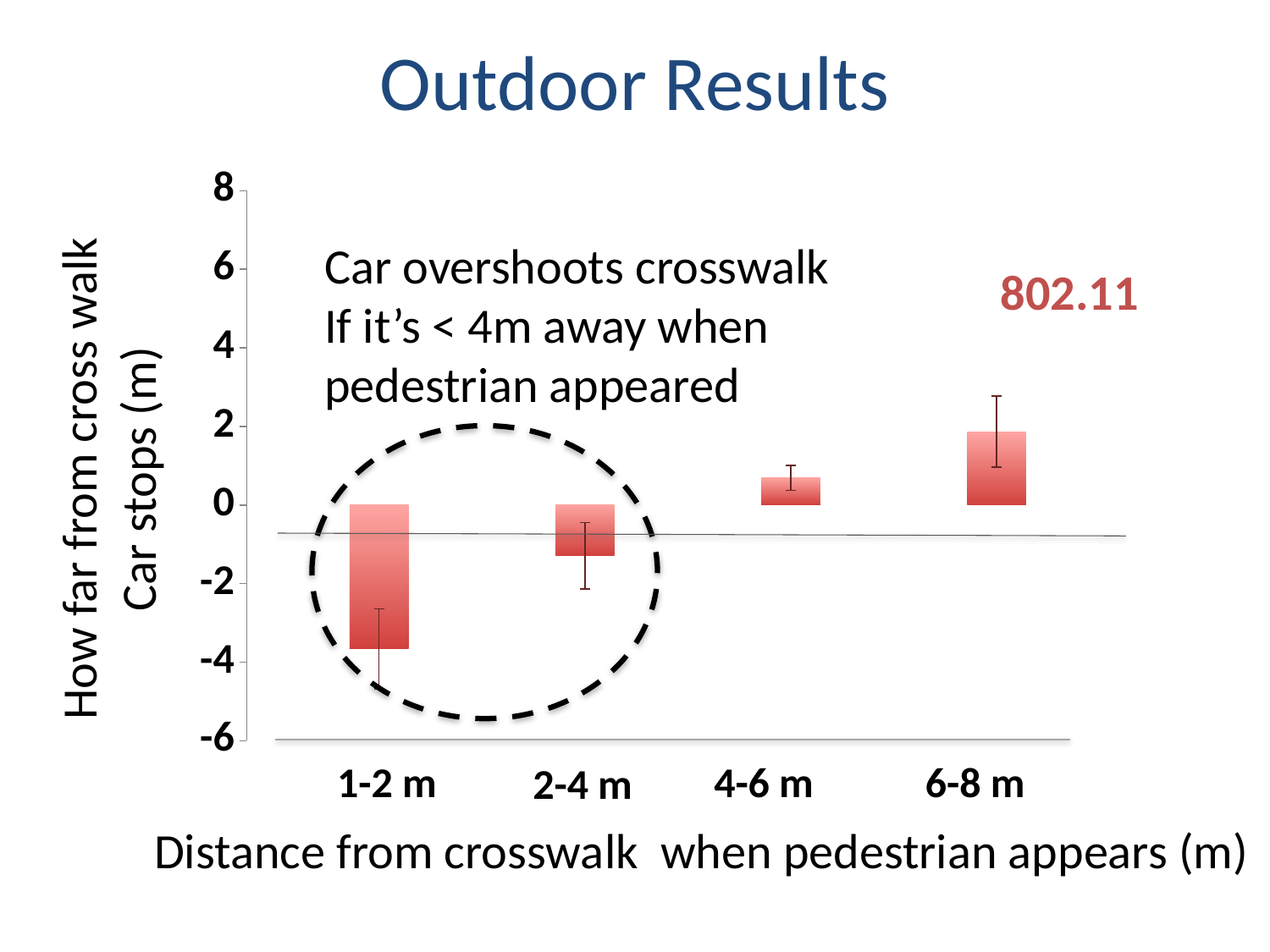
Is the value for 1-2 m greater or less than -2? less Which is larger, the value for 1-2 m or the value for 2-4 m? 2-4 m Do the values rise or fall as you move from 1-2 m to 6-8 m along the x axis? rise Which category has the highest value in the chart? 6-8 m Is the value for 2-4 m greater or less than 0? less Which is larger, the value for 2-4 m or the value for 4-6 m? 4-6 m Which category has the lowest value in the chart? 1-2 m What kind of chart is shown on the slide? bar chart What is the label of the x axis of the chart? Distance from crosswalk when pedestrian appears (m) How many categories are shown on the x axis of the chart? 4 Is the value for 6-8 m greater or less than 0? greater What is the title of the slide containing the chart? Outdoor Results